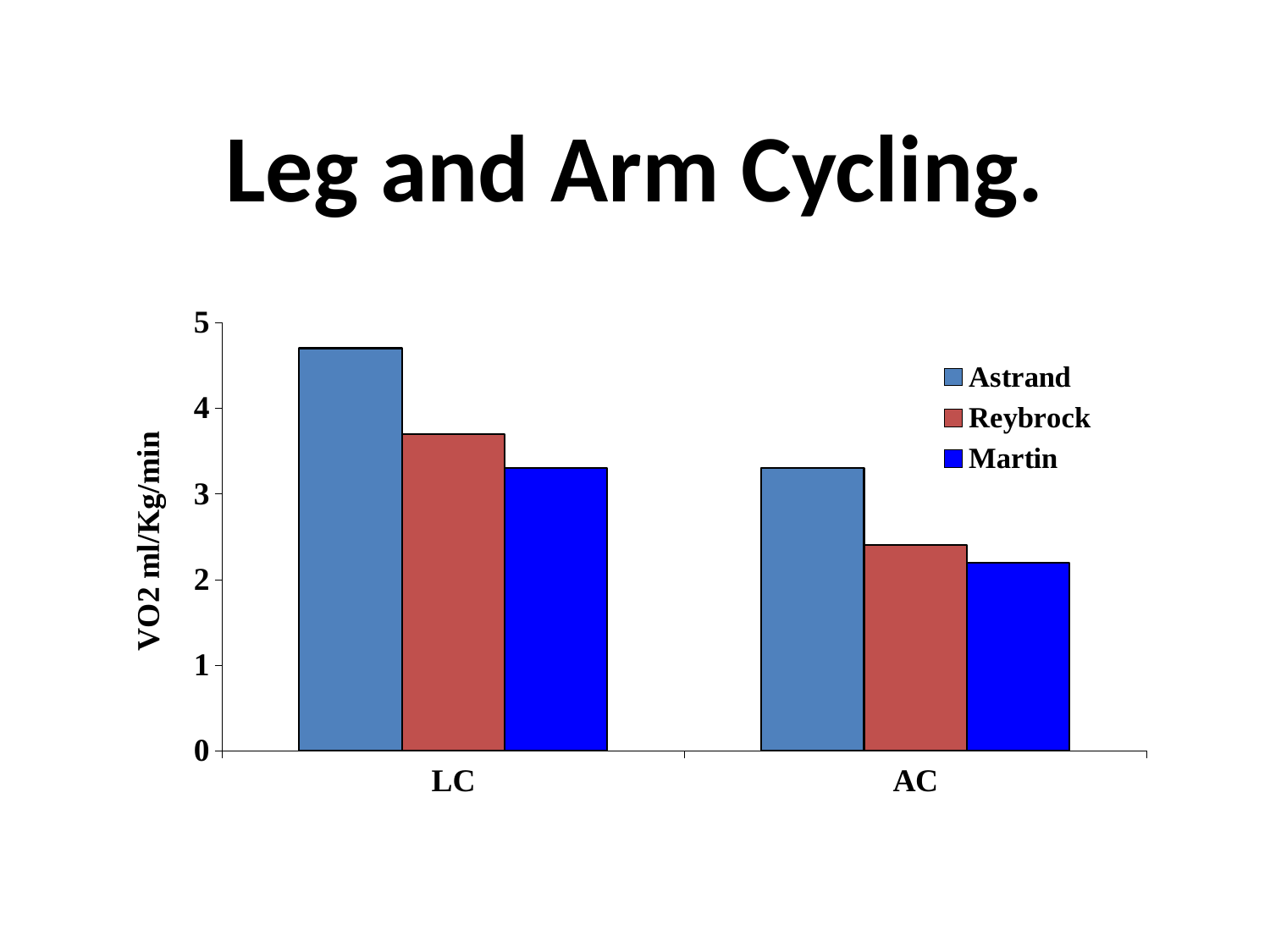
Is the Astrand value for LC greater or less than 4? greater What is the label of the y axis? VO2 ml/Kg/min Is the Reybrock value for AC greater or less than 3? less How many categories are shown on the x axis? 2 How many series does the legend list? 3 What kind of chart is shown on the slide? bar chart Is the Astrand value larger for LC or for AC? LC Which series has the highest value for AC? Astrand Is the Astrand value for AC greater or less than 4? less Which series has the highest value for LC? Astrand Which series has the lowest value for LC? Martin